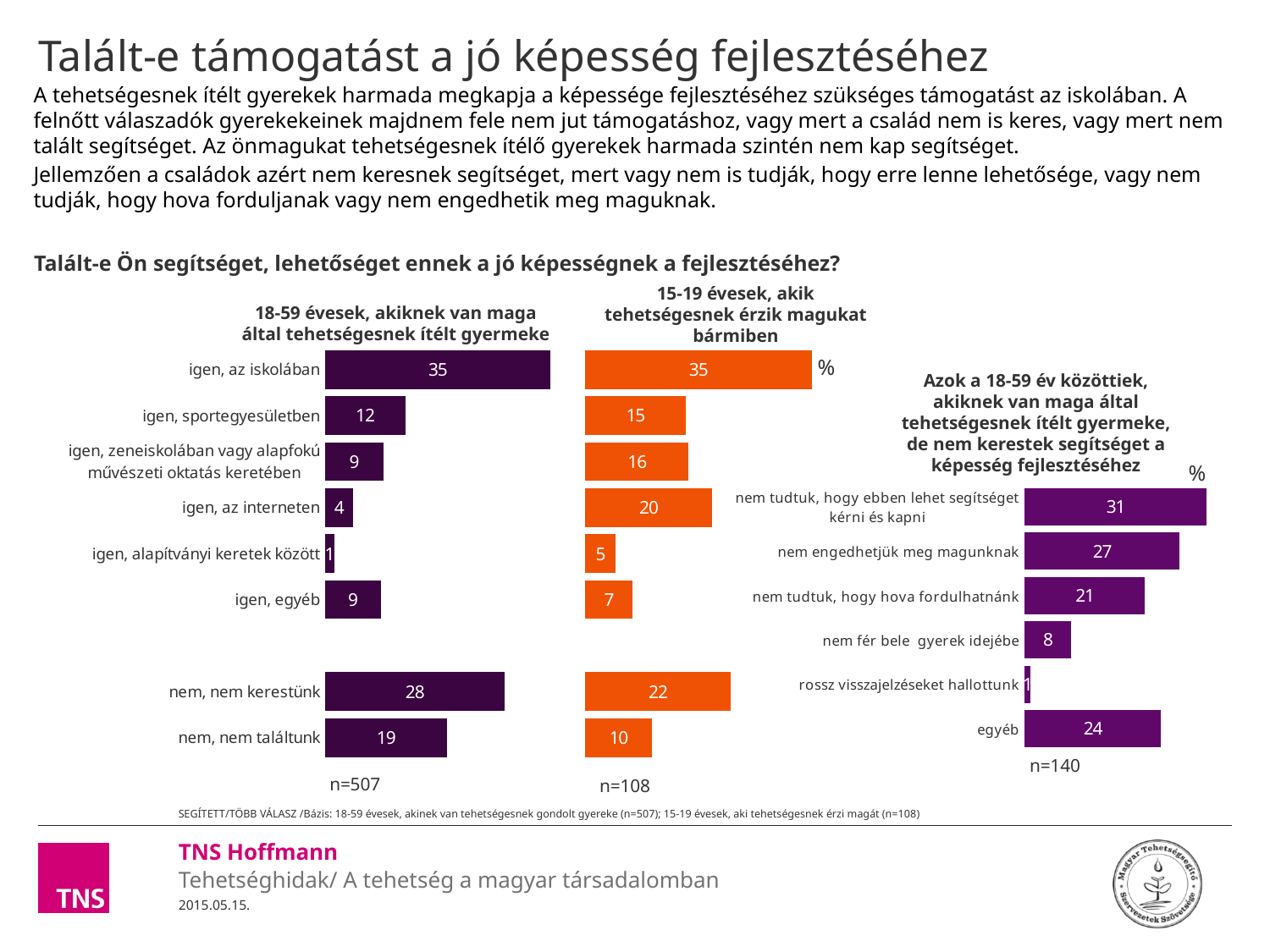
How many categories are shown in the left chart (18-59 évesek)? 8 Which is larger: the value for "igen, sportegyesületben" in the left chart (18-59 évesek) or in the middle chart (15-19 évesek)? the middle chart (15-19 évesek) In the left chart (18-59 évesek, akiknek van maga által tehetségesnek ítélt gyermeke), what is the value for "igen, az iskolában"? 35 In the left chart (18-59 évesek), what is the value for "nem, nem kerestünk"? 28 What type of chart is the middle chart (15-19 évesek, akik tehetségesnek érzik magukat bármiben)? bar chart In the middle chart (15-19 évesek), what is the difference between "nem, nem kerestünk" and "nem, nem találtunk"? 12 In the right chart (Azok a 18-59 év közöttiek, akik nem kerestek segítséget), what is the value for "nem engedhetjük meg magunknak"? 27 In the left chart (18-59 évesek), which category has the lowest value? igen, alapítványi keretek között How many categories are shown in the right chart (Azok a 18-59 év közöttiek, akik nem kerestek segítséget)? 6 In the middle chart (15-19 évesek, akik tehetségesnek érzik magukat bármiben), what is the value for "igen, az interneten"? 20 In the right chart (Azok a 18-59 év közöttiek, akik nem kerestek segítséget), which category has the highest value? nem tudtuk, hogy ebben lehet segítséget kérni és kapni What is the sample size (n) shown under the right chart (Azok a 18-59 év közöttiek, akik nem kerestek segítséget)? n=140